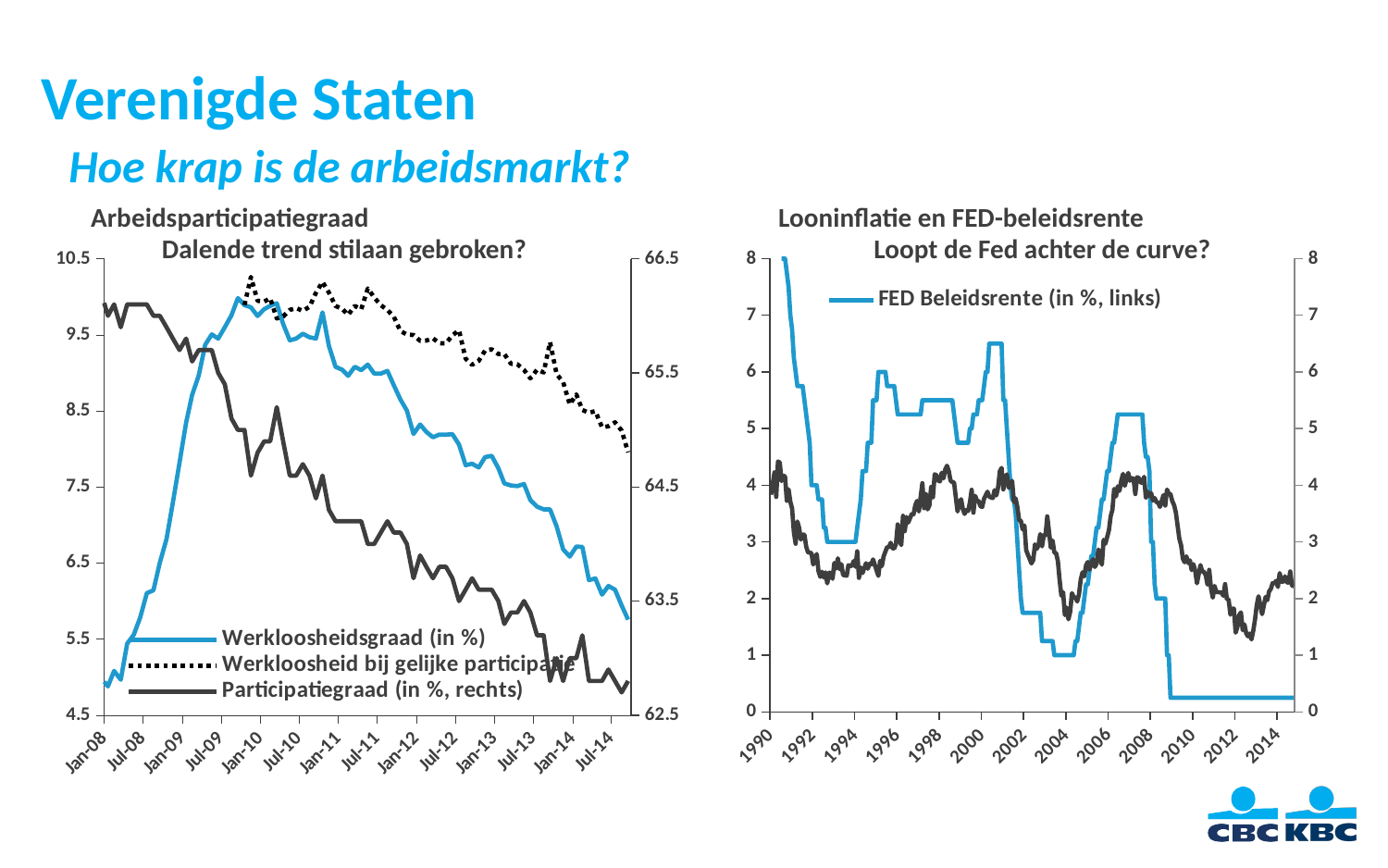
In the left chart 'Arbeidsparticipatiegraad', is the Werkloosheidsgraad (in %) at Jan-10 greater or less than 8.5? greater In the left chart 'Arbeidsparticipatiegraad', is the Werkloosheidsgraad (in %) at Jul-14 greater or less than 6.5? less What kind of chart is the right chart titled 'Looninflatie en FED-beleidsrente'? line chart What kind of chart is the left chart titled 'Arbeidsparticipatiegraad'? line chart How many series does the legend of the left chart 'Arbeidsparticipatiegraad' list? 3 In the left chart 'Arbeidsparticipatiegraad', is the Werkloosheidsgraad (in %) at Jan-08 greater or less than 5.5? less In the right chart 'Looninflatie en FED-beleidsrente', does the FED Beleidsrente (in %, links) rise or fall from 1990 to 2014 overall? fall What is the subtitle question shown under the title of the right chart? Loopt de Fed achter de curve? In the left chart 'Arbeidsparticipatiegraad', does the Participatiegraad (in %, rechts) rise or fall from Jan-08 to Jul-14? fall How many series does the legend of the right chart 'Looninflatie en FED-beleidsrente' list? 1